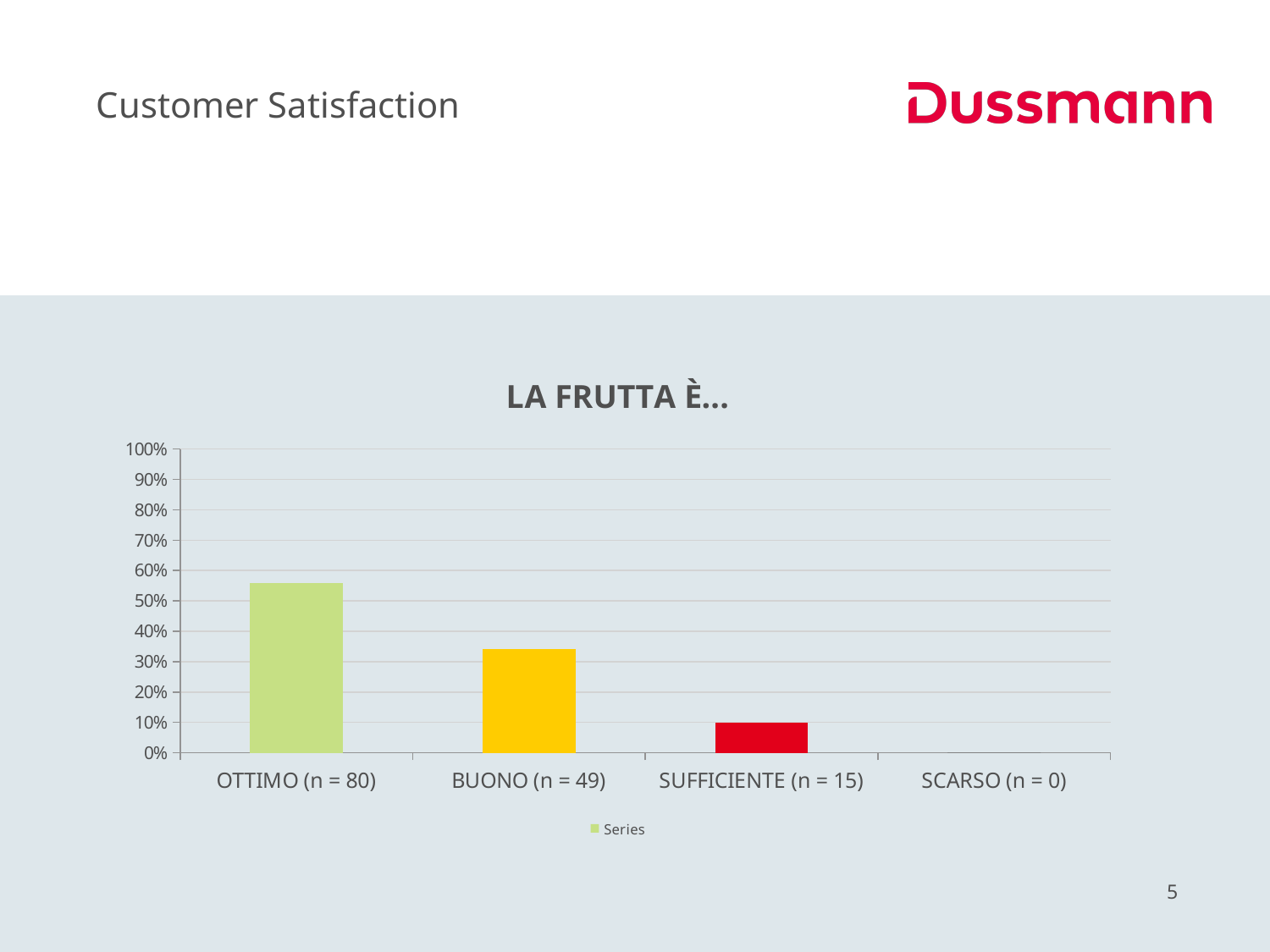
What kind of chart is shown on the slide? bar chart What is the name of the series shown in the legend? Series Which category has the highest bar? OTTIMO (n = 80) What is the title of the chart? LA FRUTTA È... Which is larger, the value for OTTIMO (n = 80) or the value for BUONO (n = 49)? OTTIMO (n = 80) Do the bar values rise or fall moving from left to right along the x axis? fall Is the value for OTTIMO (n = 80) greater or less than 50%? greater How many categories are shown on the x axis of the chart? 4 Which category has the lowest value? SCARSO (n = 0) How many series does the chart legend list? 1 Is the value for SUFFICIENTE (n = 15) greater or less than 20%? less Is the value for BUONO (n = 49) greater or less than 40%? less